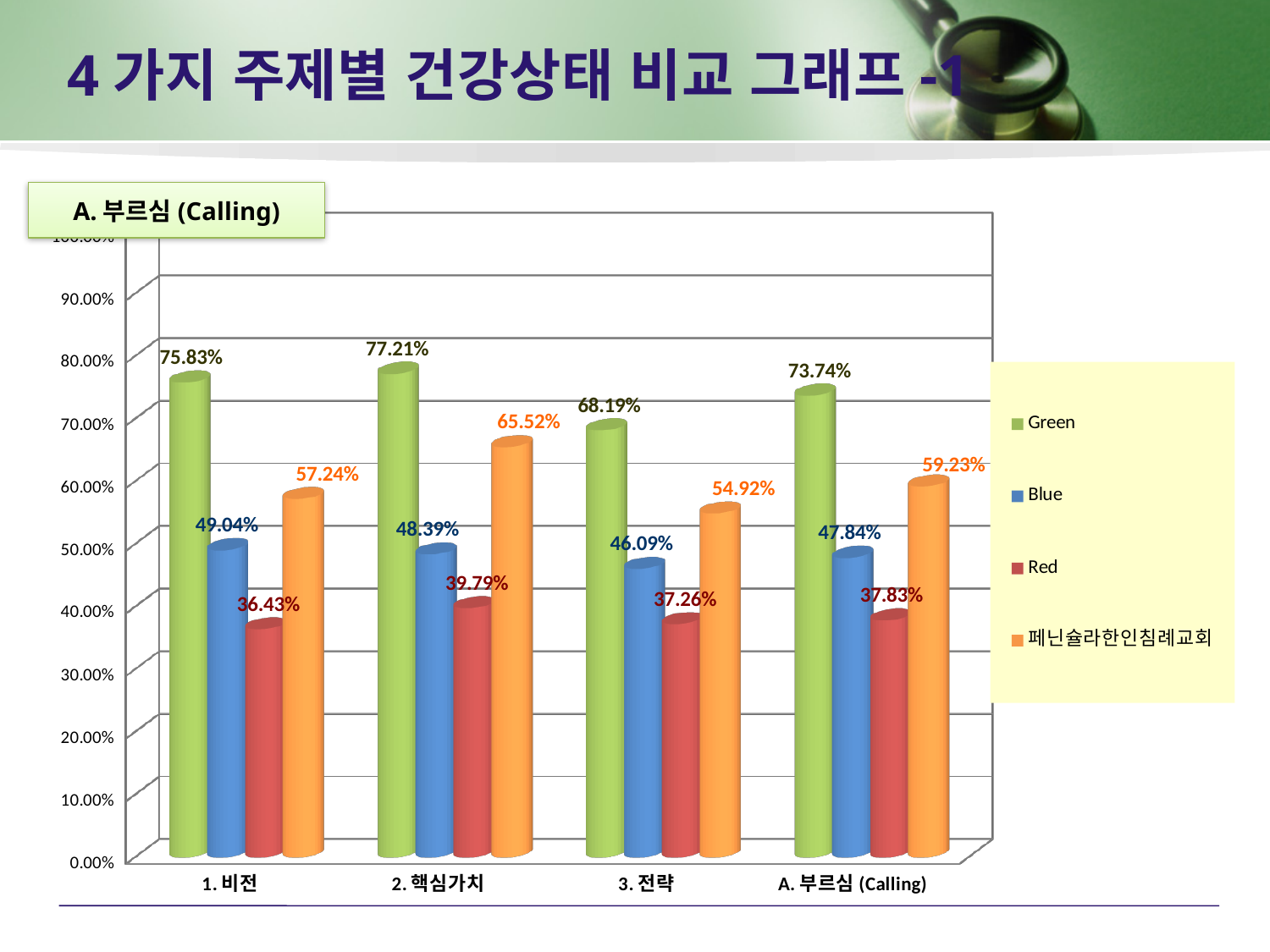
What is the value for Blue in the category A. 부르심 (Calling)? 47.84% Which is larger in the category 3. 전략: the Blue value or the 페닌슐라한인침례교회 value? 페닌슐라한인침례교회 What kind of chart is shown on the slide? Bar chart In which category does the Red series have its lowest value? 1. 비전 What is the label of the last series listed in the legend? 페닌슐라한인침례교회 What is the value for Green in the category 2. 핵심가치? 77.21% How many series does the legend list? 4 What is the value for 페닌슐라한인침례교회 in the category 1. 비전? 57.24% In which category does the Green series reach its highest value? 2. 핵심가치 How many categories are shown on the x axis? 4 What is the difference between the Green and Blue values in the category 1. 비전? 26.79% What is the value for Red in the category 3. 전략? 37.26%